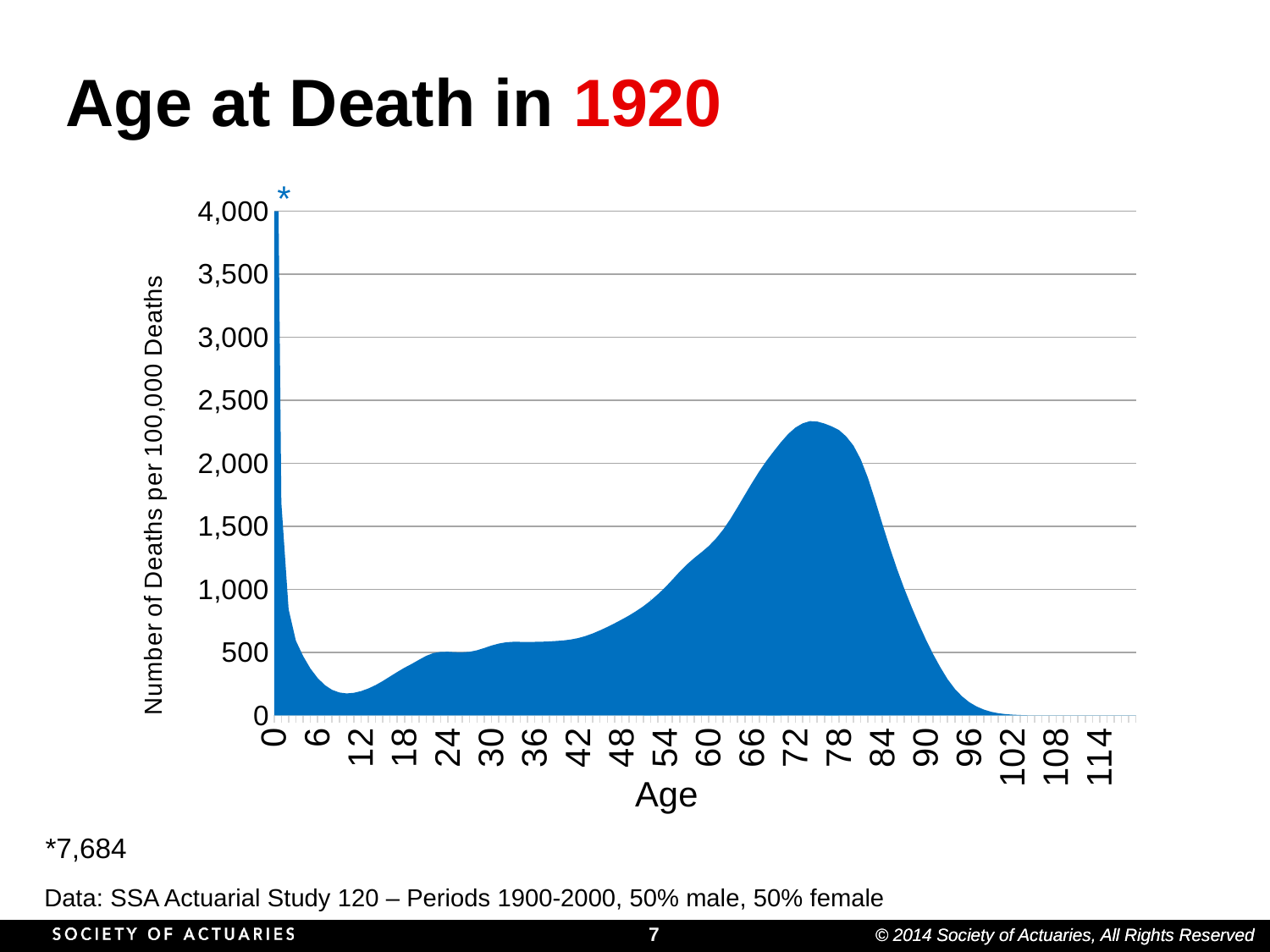
Is the value at age 74 greater or less than 2,000? greater What is the number of deaths per 100,000 deaths at age 0, as given by the asterisk footnote? 7,684 What is the title of the chart? Age at Death in 1920 What is the label of the vertical axis? Number of Deaths per 100,000 Deaths Is the value at age 48 greater or less than 1,000? less Is the value at age 12 greater or less than 500? less What kind of chart is shown on the slide? Area chart At which age is the number of deaths per 100,000 deaths highest? 0 Do the values rise or fall as age increases from 78 to 96? fall Do the values rise or fall as age increases from 48 to 72? rise